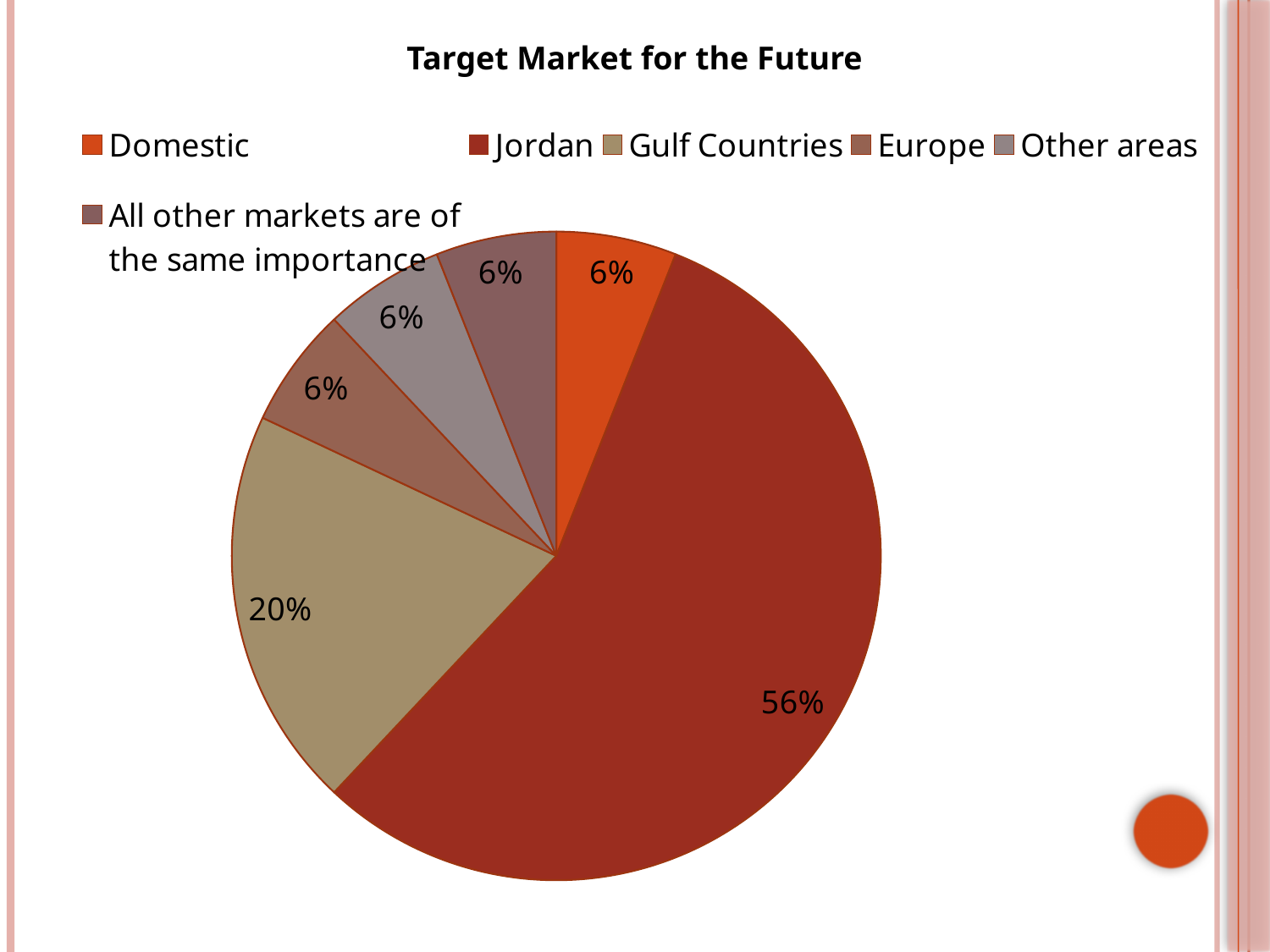
What percentage does the Domestic slice represent? 6% What is the title of the chart? Target Market for the Future How many categories are shown in the pie chart? 6 What percentage does the Europe slice represent? 6% What percentage does the Gulf Countries slice represent? 20% What kind of chart is shown on the slide? Pie chart Which category has the largest slice of the pie? Jordan Is the value for Jordan greater or less than 50%? greater Which is larger, the Gulf Countries slice or the Domestic slice? Gulf Countries What percentage does the Jordan slice represent? 56% What is the difference in percentage points between the Jordan slice and the Gulf Countries slice? 36% What share of the pie does Jordan account for? 56%